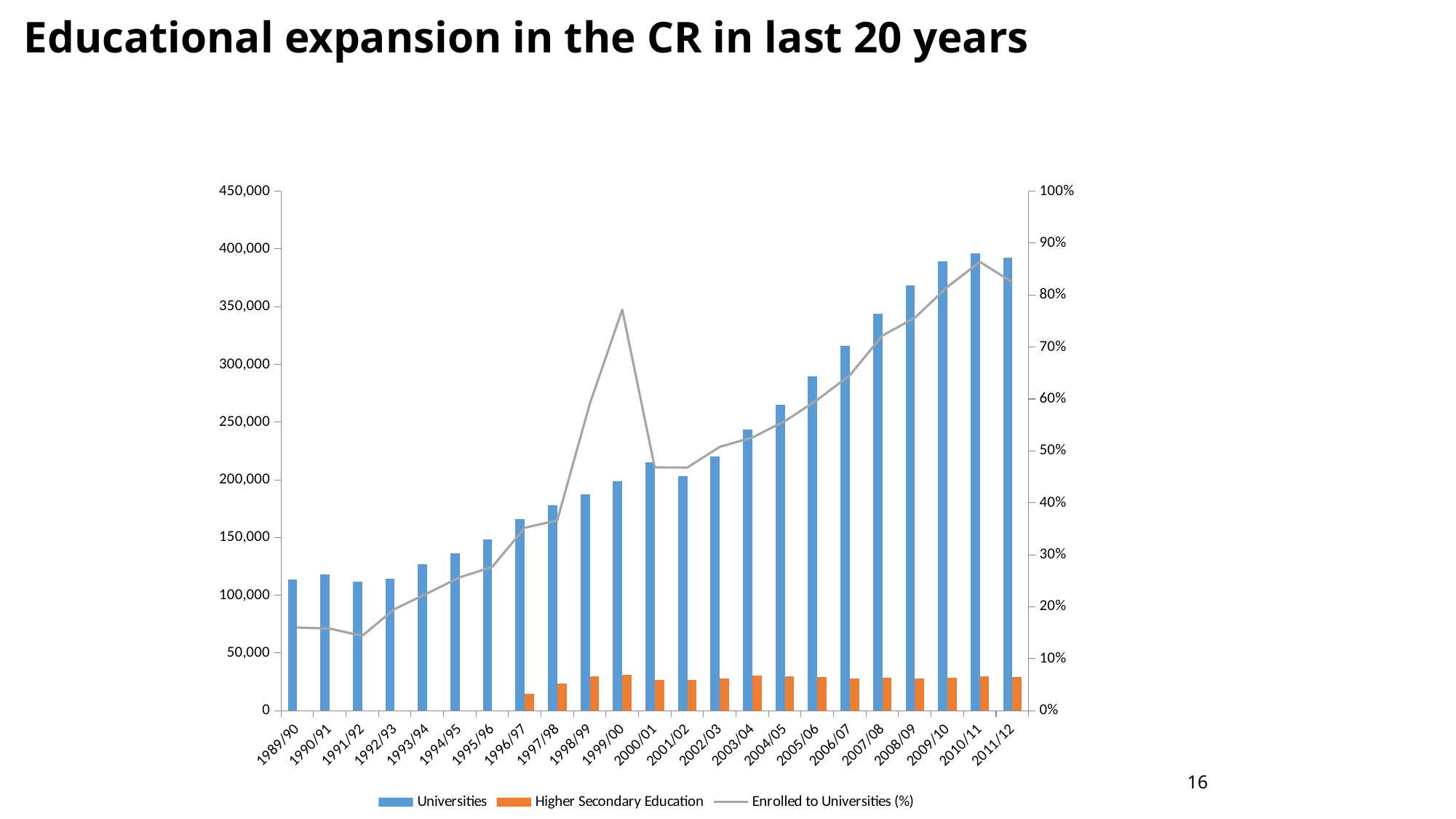
Which is larger in 2011/12, the Universities bar or the Higher Secondary Education bar? Universities Is the Universities value for 2011/12 greater or less than 350,000? greater How many series does the chart's legend list? 3 Which series is plotted as a line rather than bars? Enrolled to Universities (%) What is the title of the chart on the slide? Educational expansion in the CR in last 20 years How many academic years are shown on the x axis of the chart? 23 Is the Universities value for 2005/06 greater or less than 250,000? greater What kind of chart is shown on the slide? Bar chart with a line Is the Enrolled to Universities (%) value for 1991/92 greater or less than 20%? less Do the Universities values generally rise or fall from 1989/90 to 2011/12? rise